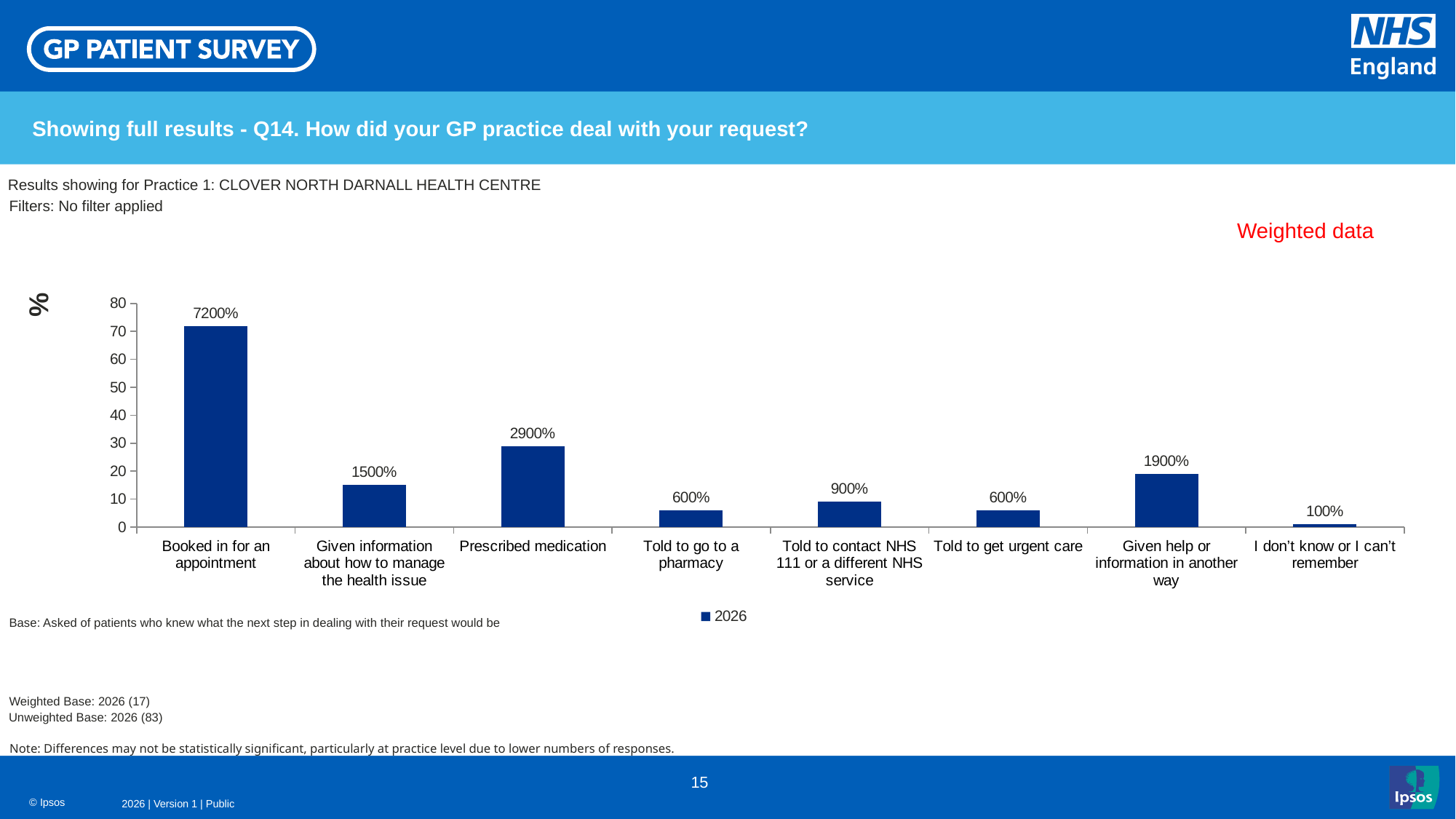
What is the data label shown for "Booked in for an appointment"? 7200% Is the bar for "Given help or information in another way" greater or less than 10 on the axis? greater How many series does the legend list? 1 What is the data label shown for "Given help or information in another way"? 1900% Which category has the lowest bar? I don't know or I can't remember How many categories are shown on the x axis? 8 What type of chart is shown on the slide? Bar chart What is the data label shown for "Told to contact NHS 111 or a different NHS service"? 900% Which category has the highest bar? Booked in for an appointment What is the data label shown for "Prescribed medication"? 2900% Is the bar for "Told to get urgent care" greater or less than 10 on the axis? less Which bar is taller: "Prescribed medication" or "Given information about how to manage the health issue"? Prescribed medication